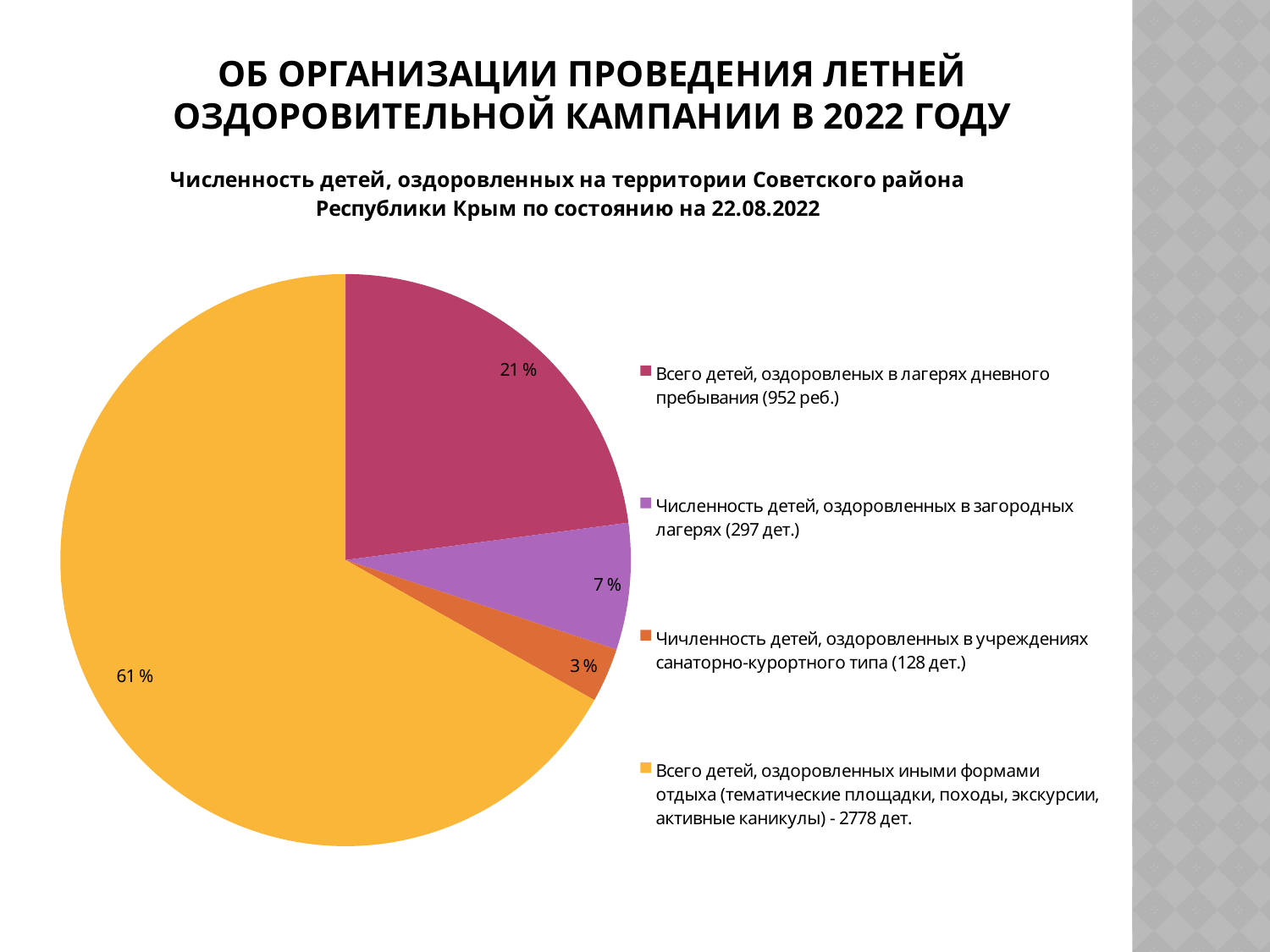
What share of the pie is labelled for children in out-of-town camps (загородные лагеря)? 7 % What kind of chart is shown on the slide? pie chart Which category has the smallest slice of the pie? Численность детей, оздоровленных в учреждениях санаторно-курортного типа What share of the pie is labelled for children in sanatorium-resort institutions? 3 % How many entries does the legend list? 4 What is the difference in percentage points between the slice for other forms of recreation and the slice for day-stay camps? 40 According to the legend, how many children were in day-stay camps? 952 Which slice is larger: day-stay camps or out-of-town camps? day-stay camps What share of the pie is labelled for children in day-stay camps (лагеря дневного пребывания)? 21 % Which category has the largest slice of the pie? Всего детей, оздоровленных иными формами отдыха What share of the pie is labelled for children in other forms of recreation (иные формы отдыха)? 61 % How many slices does the pie chart have? 4